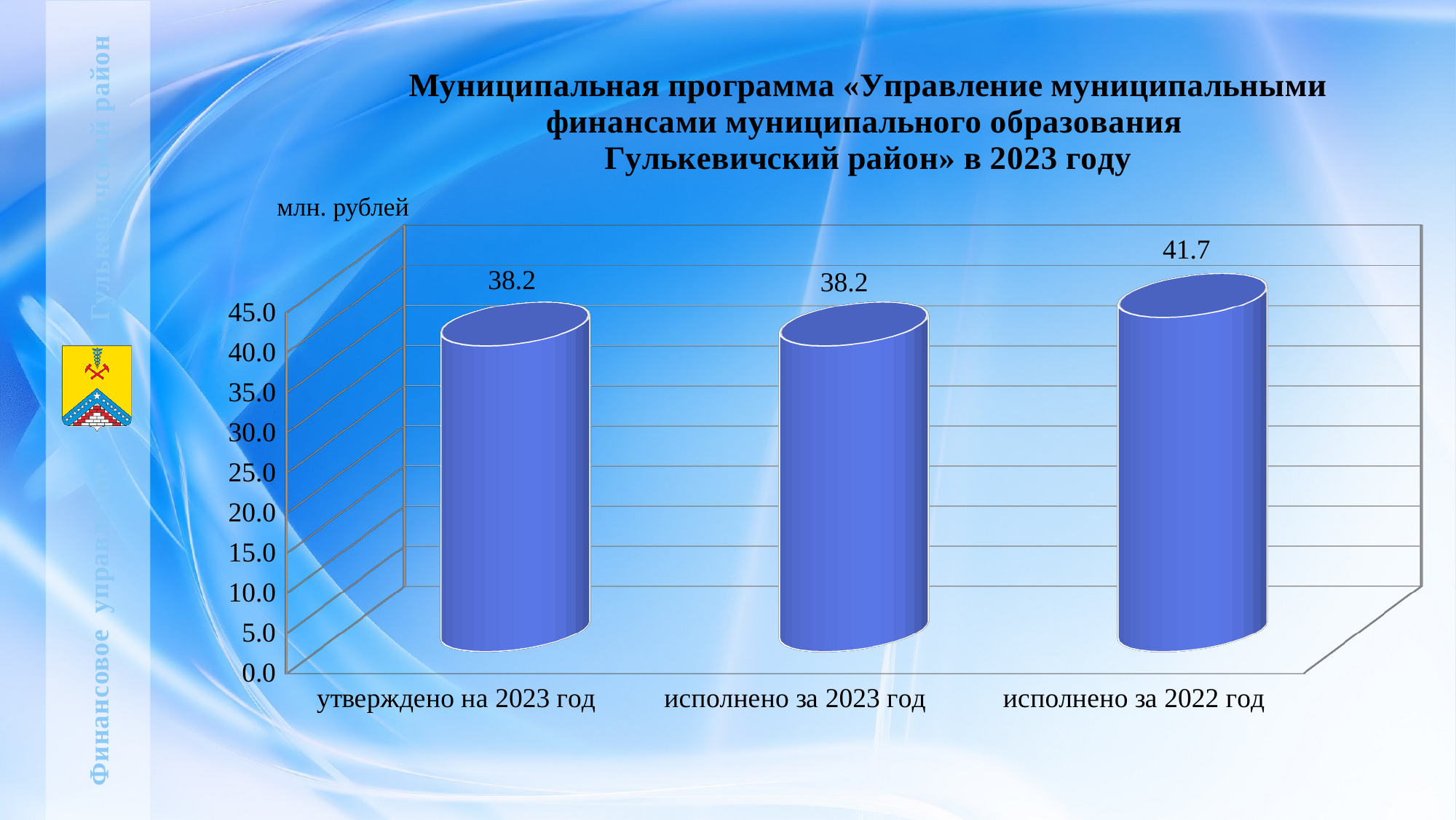
What is the value for «исполнено за 2023 год»? 38.2 What kind of chart is shown on the slide? bar chart How many categories are shown on the chart? 3 What is the value for «утверждено на 2023 год»? 38.2 Which is larger: the value for «исполнено за 2022 год» or the value for «утверждено на 2023 год»? исполнено за 2022 год What is the difference between the value for «исполнено за 2022 год» and the value for «исполнено за 2023 год»? 3.5 What is the highest tick value shown on the vertical axis? 45.0 Is the value for «утверждено на 2023 год» greater or less than 40.0? less What unit of measurement is indicated above the vertical axis? млн. рублей What is the value for «исполнено за 2022 год»? 41.7 Is the value for «исполнено за 2022 год» greater or less than 40.0? greater Which category has the highest value? исполнено за 2022 год